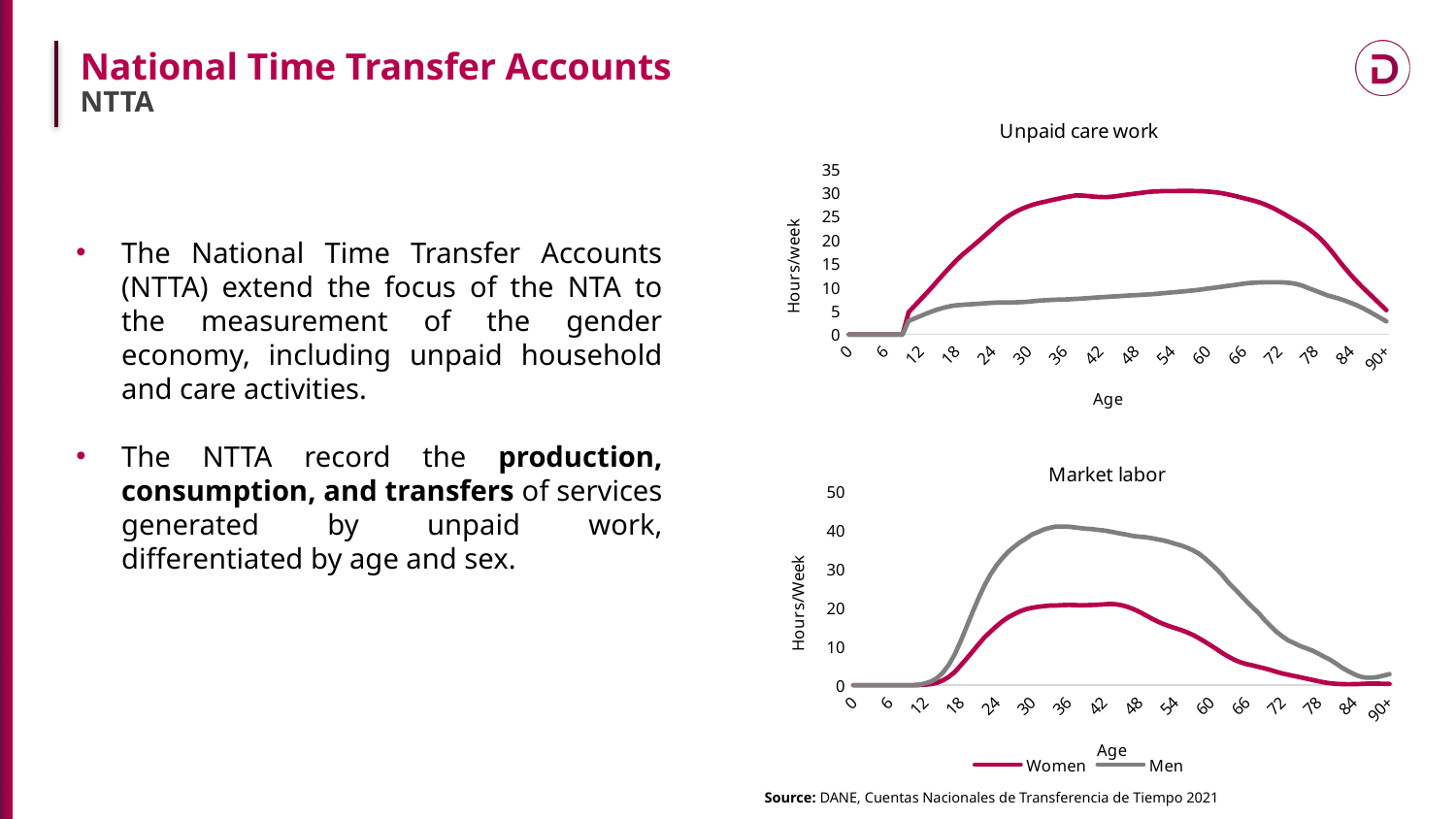
In the 'Unpaid care work' chart, is the value for Men at age 30 greater or less than 10? less How many age tick labels are shown on the x axis of the 'Market labor' chart? 16 In the 'Market labor' chart, is the value for Men at age 36 greater or less than 30? greater In the 'Market labor' chart, which series is higher at age 30, Women or Men? Men What kind of chart is the 'Unpaid care work' chart? line chart What is the y-axis label of the 'Market labor' chart? Hours/Week In the 'Unpaid care work' chart, do the values for Women rise or fall from age 60 to 90+? fall In the 'Unpaid care work' chart, which series is higher at age 42, Women or Men? Women In the 'Market labor' chart, is the value for Women at age 66 greater or less than 10? less How many series does the legend list for the charts? 2 In the 'Market labor' chart, do the values for Men rise or fall from age 12 to age 36? rise